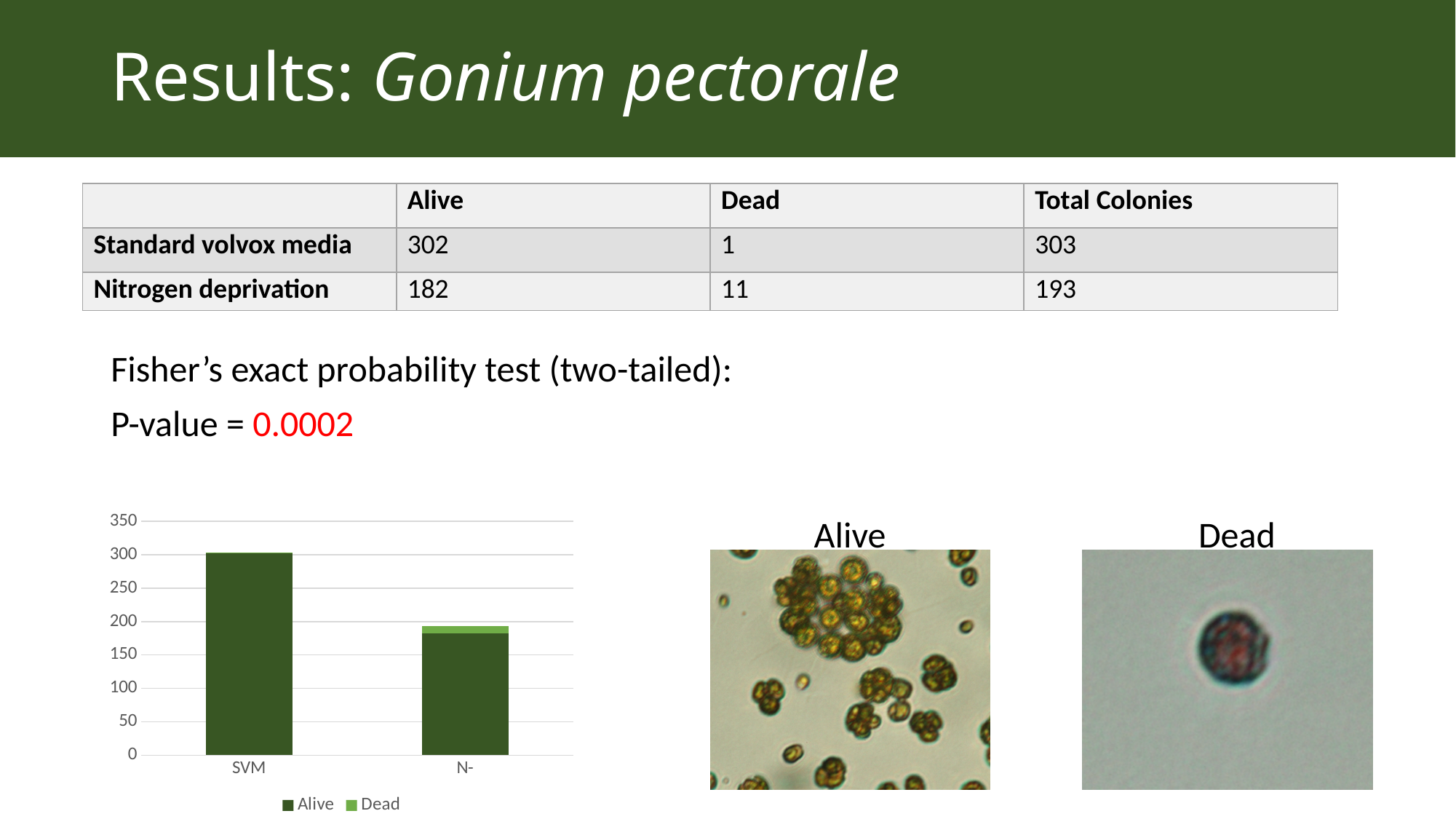
How many categories are shown on the x axis of the bar chart? 2 What kind of chart is shown at the bottom left of the slide? bar chart Is the total height of the stacked bar for N- greater or less than 150? greater Which category has the lowest Alive value in the bar chart? N- Which category has the highest Alive value in the bar chart? SVM Which category has the taller stacked bar in the bar chart, SVM or N-? SVM What are the two series named in the legend of the bar chart? Alive and Dead Is the Alive value for SVM in the bar chart greater or less than 250? greater What are the two category labels on the x axis of the bar chart? SVM and N- Is the Alive value for N- in the bar chart greater or less than 200? less How many series does the legend of the bar chart list? 2 Do the Alive values rise or fall from SVM to N- along the x axis of the bar chart? fall